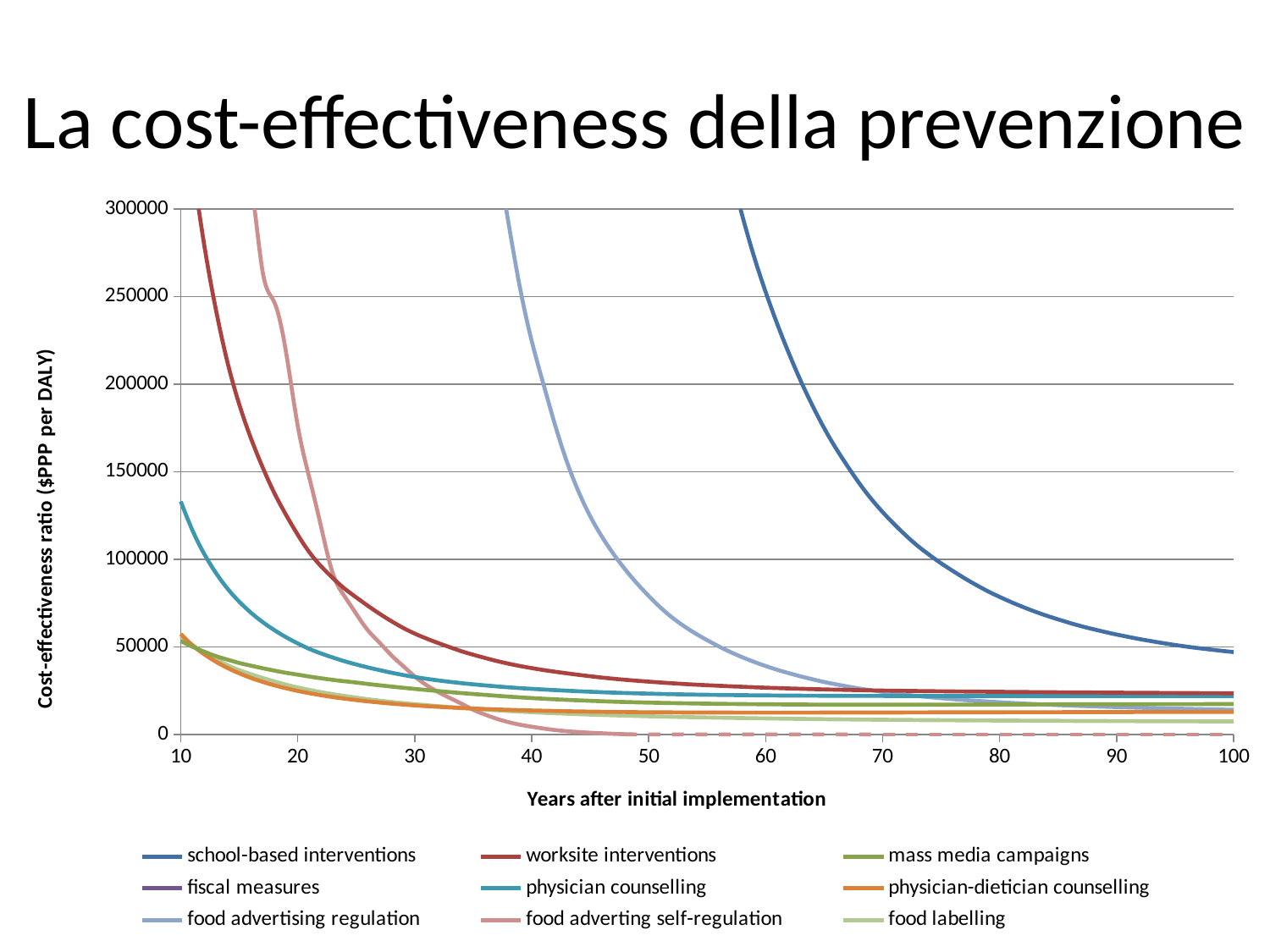
What is the label of the x axis? Years after initial implementation Is the value for school-based interventions at 80 years greater or less than 50000? greater At 100 years after initial implementation, which is larger: school-based interventions or worksite interventions? school-based interventions Do the values for school-based interventions rise or fall as years after initial implementation increase? fall Which series has the highest cost-effectiveness ratio at 100 years after initial implementation? school-based interventions Is the value for food advertising regulation at 50 years greater or less than 50000? greater What kind of chart is shown on the slide? line chart How many series does the legend list? 9 Is the value for worksite interventions at 40 years greater or less than 50000? less At 20 years after initial implementation, which is larger: worksite interventions or physician counselling? worksite interventions What is the title of the slide? La cost-effectiveness della prevenzione